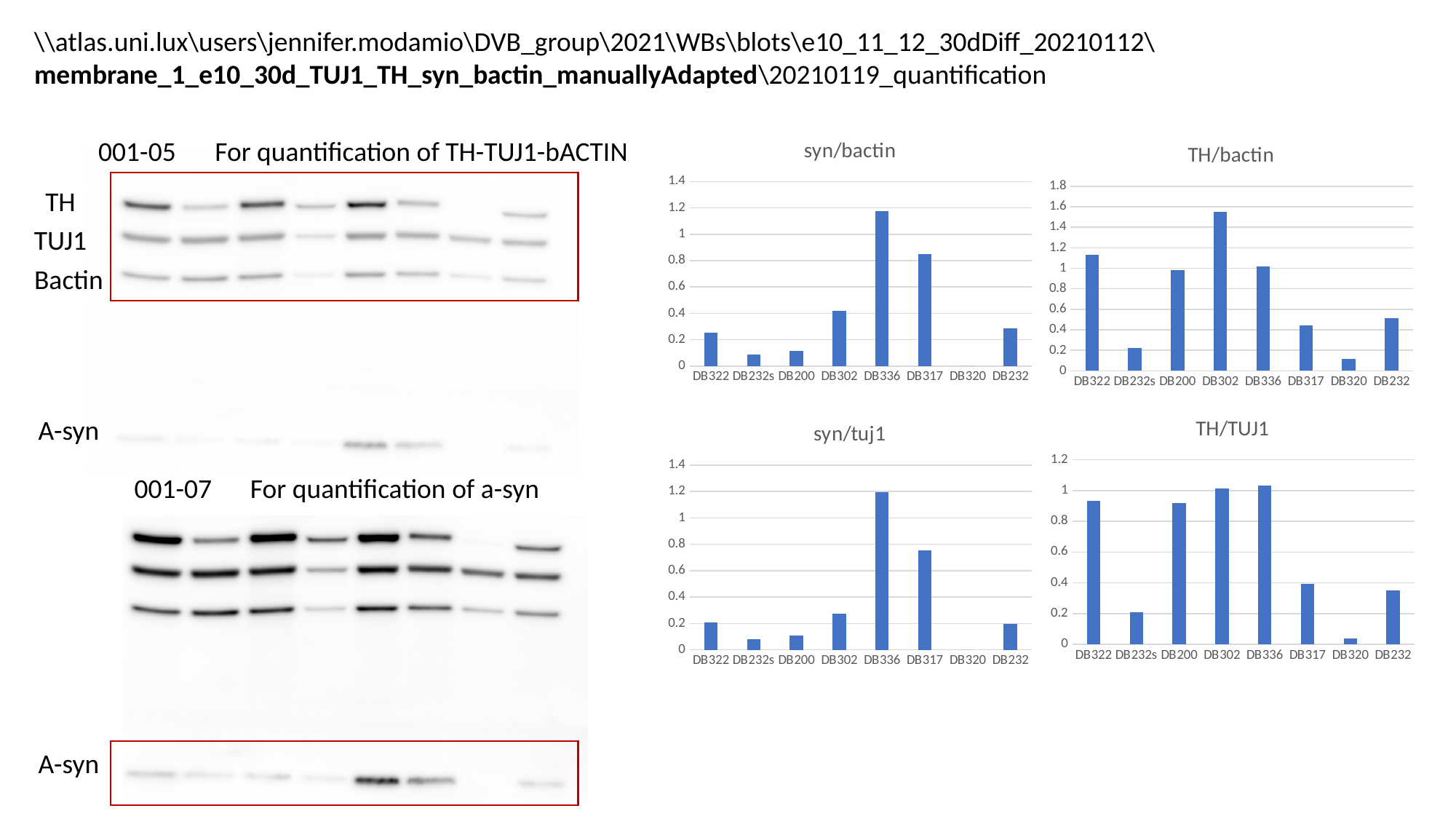
In the TH/bactin chart, which category has the highest value? DB302 In the syn/tuj1 chart, which category has the highest value? DB336 What kind of chart is the syn/tuj1 chart? bar chart In the TH/bactin chart, is the value for DB317 greater or less than 0.6? less In the TH/bactin chart, which category has the lowest value? DB320 How many categories are shown on the x axis of the TH/TUJ1 chart? 8 In the syn/tuj1 chart, is the value for DB317 greater or less than 0.6? greater In the syn/bactin chart, which category has the highest value? DB336 In the TH/TUJ1 chart, is the value for DB322 greater or less than 0.8? greater In the TH/TUJ1 chart, which category has the lowest value? DB320 In the syn/bactin chart, which is larger, the value for DB302 or the value for DB322? DB302